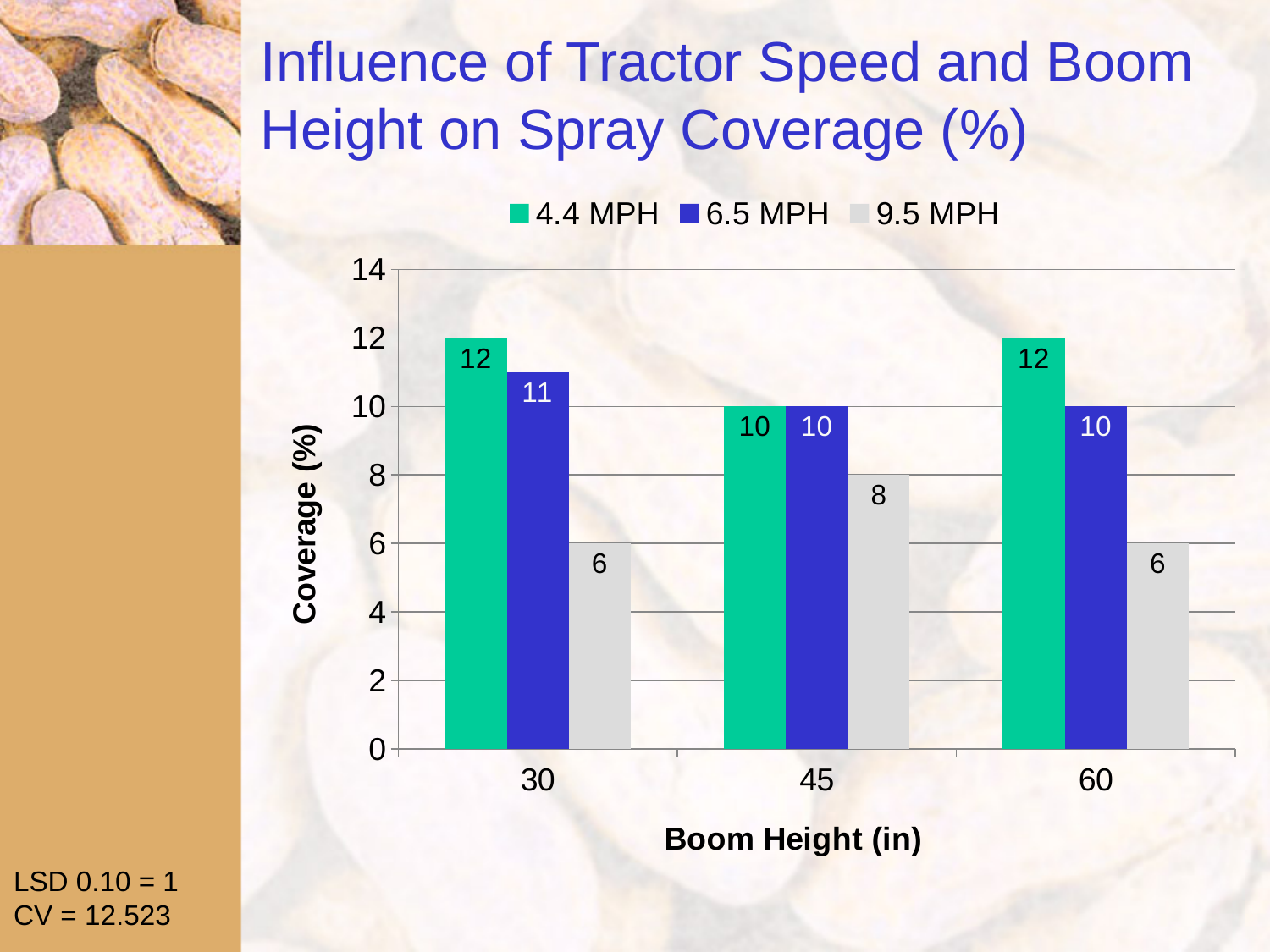
At which boom height is the coverage for 4.4 MPH lowest? 45 What is the difference in coverage (%) between 4.4 MPH and 9.5 MPH at a boom height of 30 in? 6 What is the label of the y axis? Coverage (%) What is the coverage (%) for 9.5 MPH at a boom height of 45 in? 8 What is the coverage (%) for 4.4 MPH at a boom height of 30 in? 12 How many series does the legend list? 3 What kind of chart is shown on the slide? bar chart At which boom height is the coverage for 9.5 MPH highest? 45 Which series is shown in grey in the legend? 9.5 MPH Which has higher coverage at a boom height of 60 in: 6.5 MPH or 9.5 MPH? 6.5 MPH How many boom height categories are shown on the x axis? 3 What is the coverage (%) for 6.5 MPH at a boom height of 60 in? 10